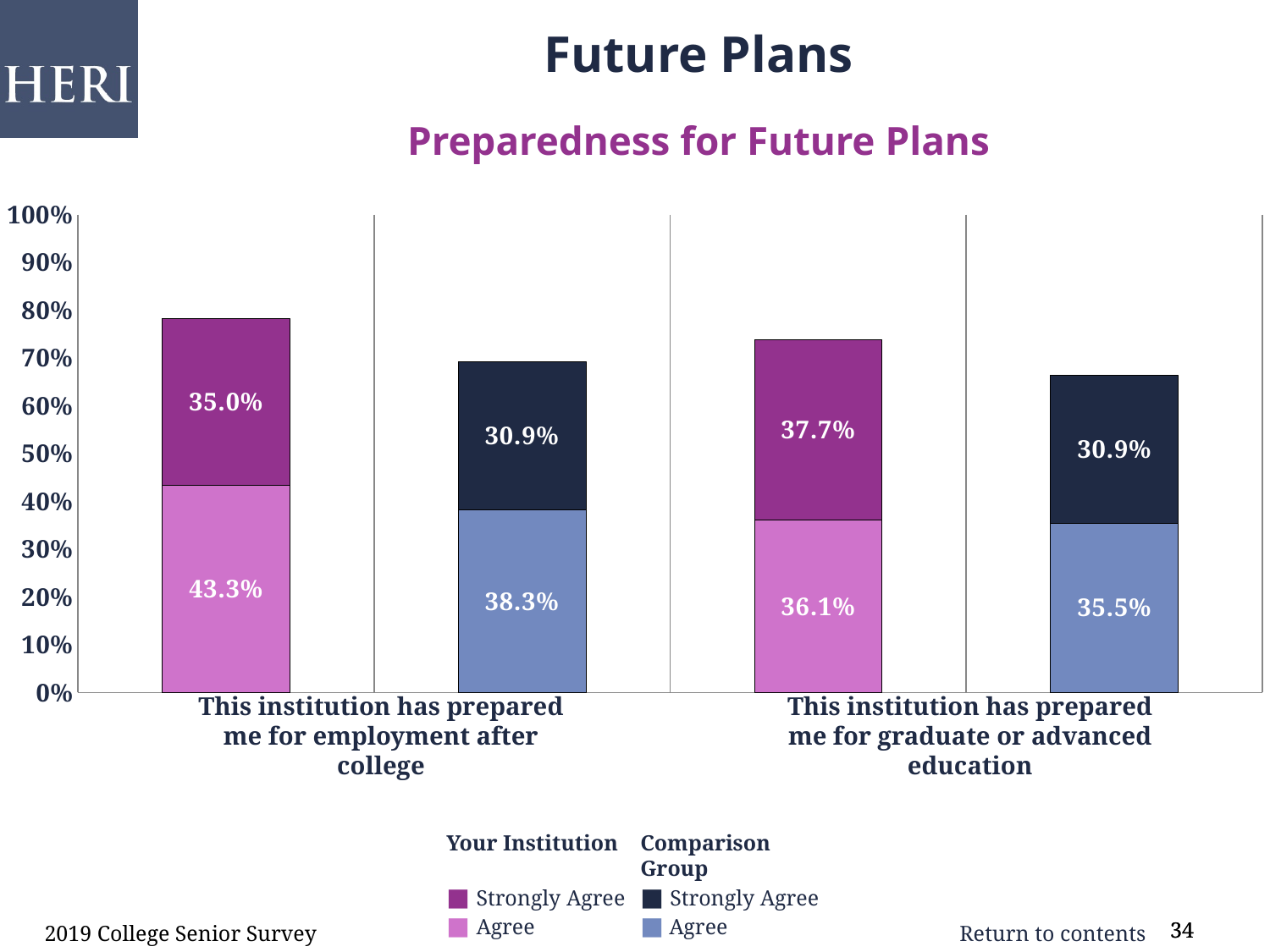
What is the combined Agree and Strongly Agree total for Your Institution on "This institution has prepared me for employment after college"? 78.3% What percentage of Your Institution respondents selected Agree for "This institution has prepared me for employment after college"? 43.3% For "This institution has prepared me for graduate or advanced education", which is larger: the Your Institution Strongly Agree value or the Comparison Group Strongly Agree value? Your Institution Strongly Agree What is the combined Agree and Strongly Agree total for the Comparison Group on "This institution has prepared me for graduate or advanced education"? 66.4% Is the total stacked bar for the Comparison Group on "This institution has prepared me for employment after college" greater or less than 60%? greater What kind of chart is shown on the slide? Stacked bar chart What is the difference between the Your Institution Agree value and the Comparison Group Agree value for "This institution has prepared me for employment after college"? 5.0% What is the title of the chart on the slide? Preparedness for Future Plans What percentage of the Comparison Group selected Strongly Agree for "This institution has prepared me for employment after college"? 30.9% How many survey statements (categories) are shown on the x axis of the chart? 2 What percentage of the Comparison Group selected Agree for "This institution has prepared me for graduate or advanced education"? 35.5% What percentage of Your Institution respondents selected Strongly Agree for "This institution has prepared me for graduate or advanced education"? 37.7%